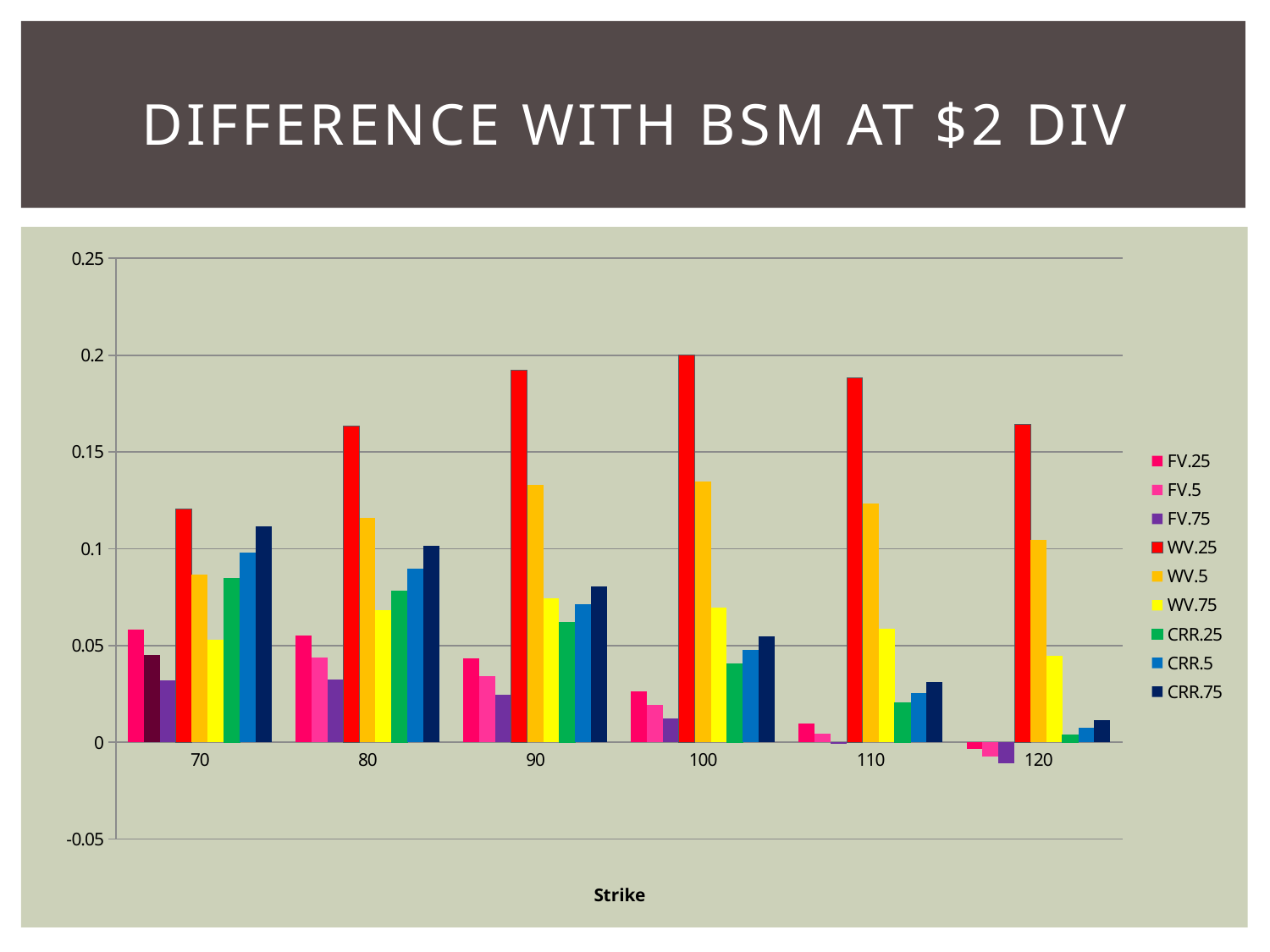
Is the value for CRR.75 at strike 120 greater or less than 0.05? less What kind of chart is shown on the slide? bar chart What is the title of the slide? DIFFERENCE WITH BSM AT $2 DIV At which strike is the WV.25 value lowest? 70 What is the title of the x axis? Strike How many strike categories are shown on the x axis? 6 At strike 80, which is larger, WV.5 or WV.75? WV.5 Do the FV.25 values rise or fall as the strike increases from 70 to 120? fall Is the value for WV.25 at strike 70 greater or less than 0.1? greater Which series has the highest value at strike 90? WV.25 Is the value for WV.25 at strike 100 greater or less than 0.15? greater How many series does the legend list? 9